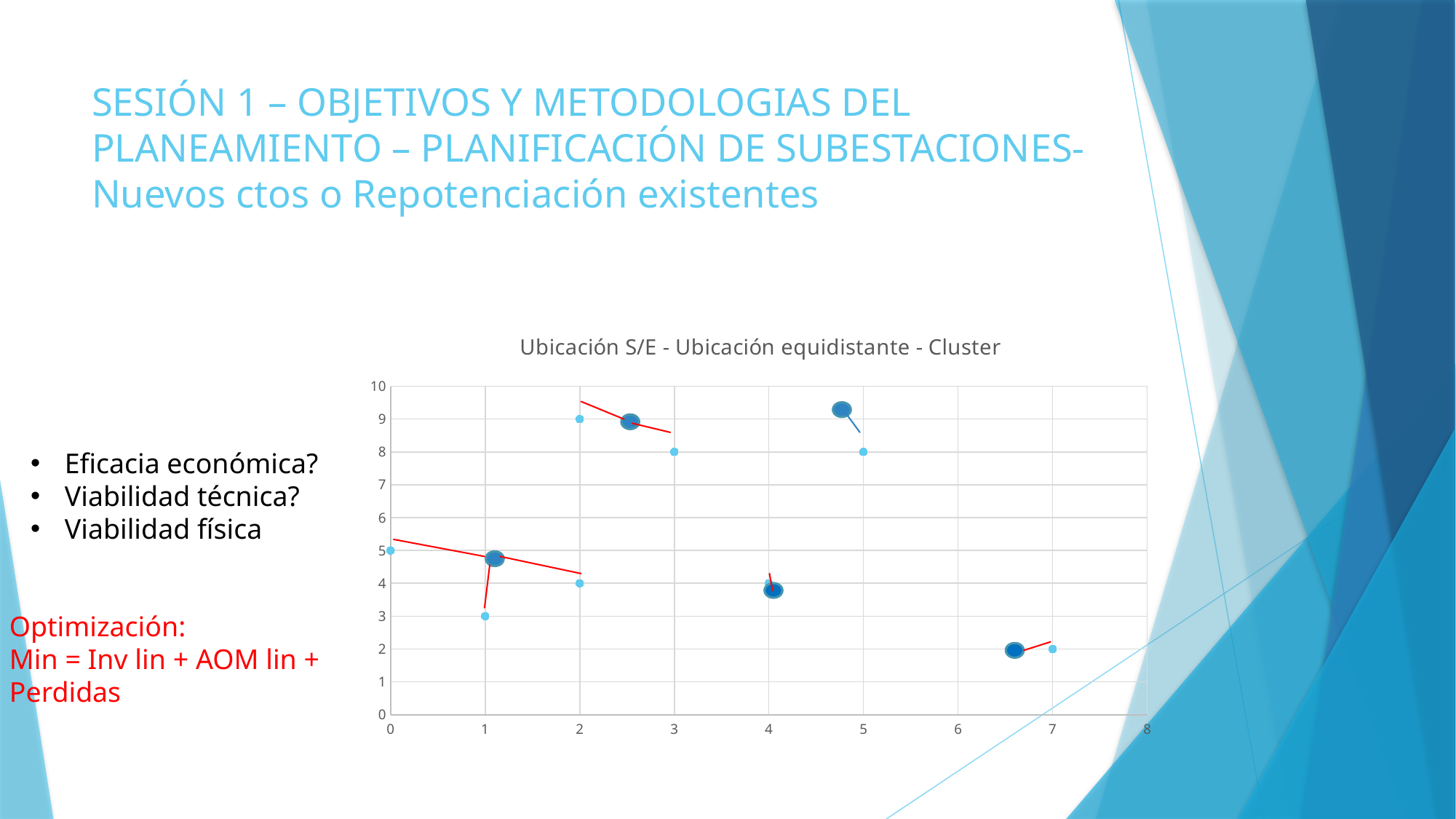
Is the y value of the large point located near x = 5 greater or less than 8? greater What is the y value of the small point plotted at x = 5? 8 What is the maximum value shown on the vertical axis of the chart? 10 What is the y value of the small point plotted at x = 0? 5 Is the y value of the large point located near x = 4 greater or less than 5? less What is the title of the chart? Ubicación S/E - Ubicación equidistante - Cluster What is the y value of the small point plotted at x = 1? 3 Which small point has the highest y value? the point at x = 2, y = 9 What is the y value of the small point plotted at x = 7? 2 How many large dark-blue points are plotted on the chart? 5 What kind of chart is shown on the slide? scatter chart